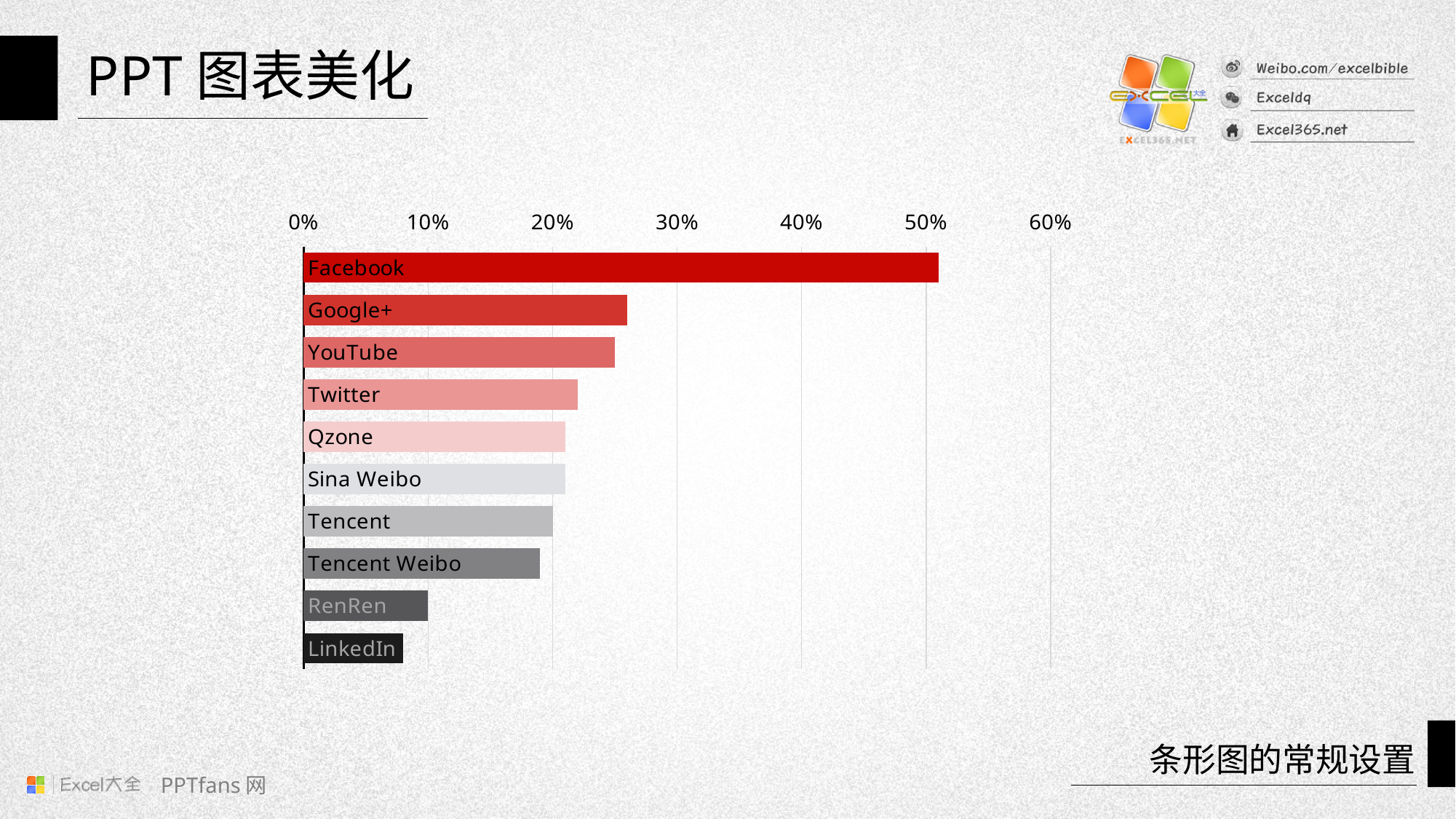
Is the value for Facebook greater or less than 50%? greater Which is larger, the value for RenRen or the value for Tencent? Tencent Is the value for LinkedIn greater or less than 10%? less Which is larger, the value for Twitter or the value for LinkedIn? Twitter Which is larger, the value for Facebook or the value for Google+? Facebook Is the value for Google+ greater or less than 30%? less What is the highest percentage tick shown on the chart's axis? 60% Which category has the highest value in the chart? Facebook What kind of chart is shown on the slide? bar chart How many categories (bars) does the chart show? 10 Which category has the lowest value in the chart? LinkedIn